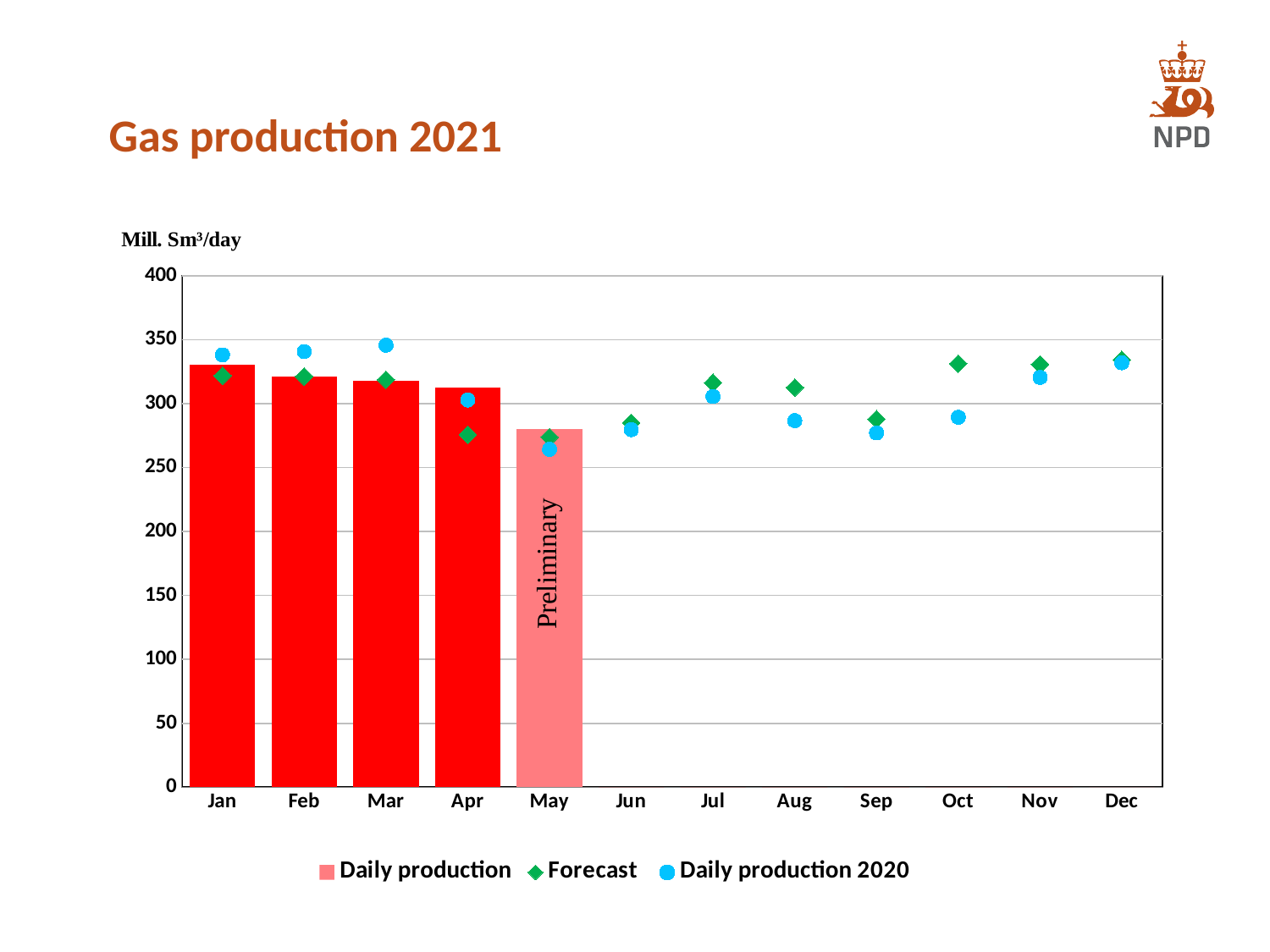
How many months are shown on the x axis? 12 Is the Daily production 2020 value for Mar greater or less than 300? greater How many series does the legend list? 3 What kind of chart is shown on the slide? bar chart with point markers For how many months is a Daily production bar plotted? 5 Do the Daily production bars rise or fall from Jan to May? fall Which month has the highest Daily production bar? Jan Is the Daily production value for May greater or less than 300? less Which month's bar is labelled "Preliminary"? May Which is larger, the Daily production 2020 value for Mar or for Sep? Mar Is the Daily production value for Jan greater or less than 300? greater Which month has the lowest Daily production bar? May